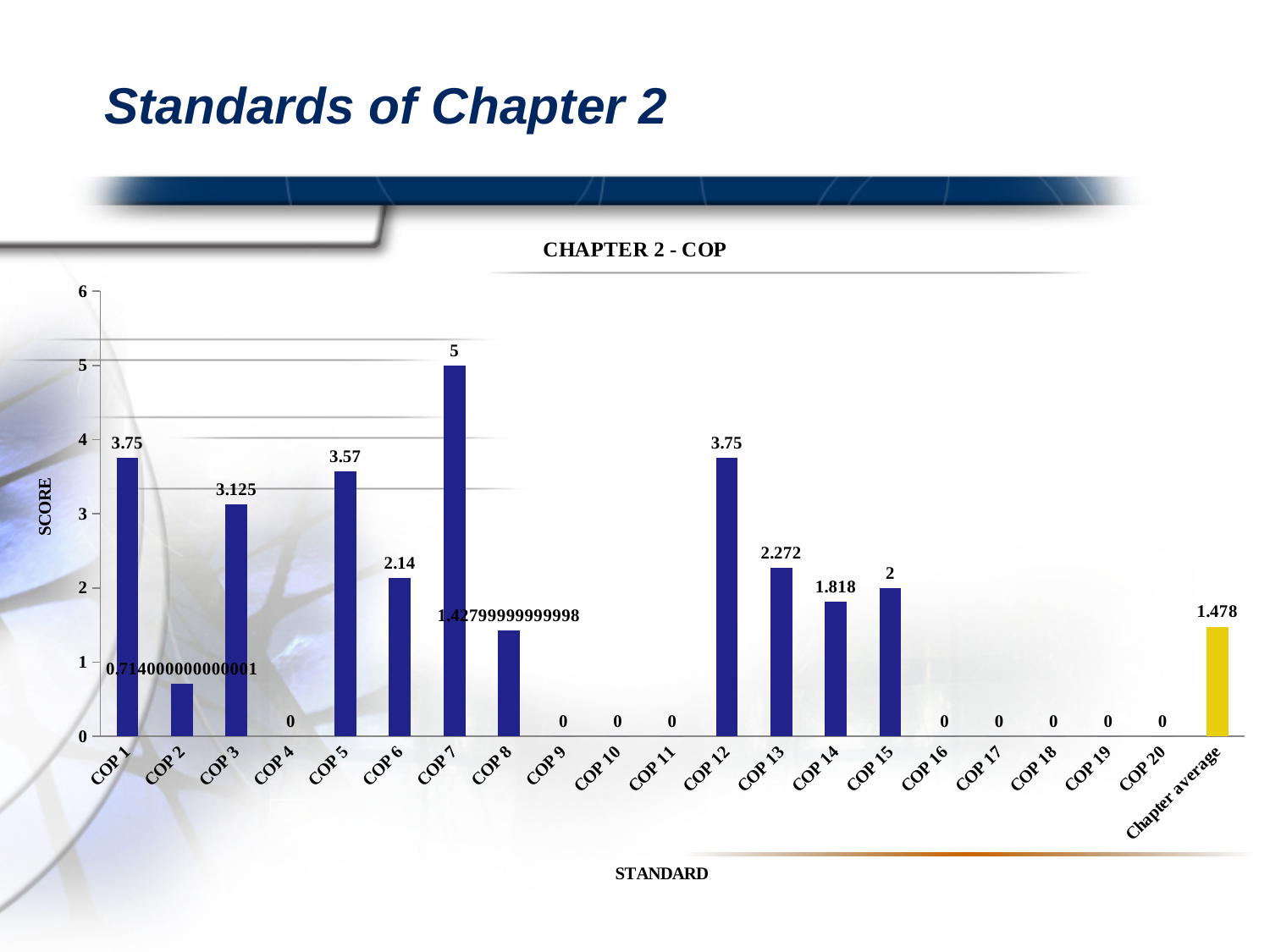
What is the label of the vertical axis? SCORE What is the value shown for Chapter average? 1.478 Which has a higher score, COP 3 or COP 6? COP 3 What is the score for COP 13? 2.272 What kind of chart is shown on the slide? bar chart What is the title of the chart? CHAPTER 2 - COP What is the score for COP 5? 3.57 Is the value for COP 2 greater or less than 1? less What is the score for COP 14? 1.818 How many categories are shown on the x axis, including Chapter average? 21 What is the difference between the scores of COP 7 and COP 12? 1.25 Which standard has the highest score? COP 7